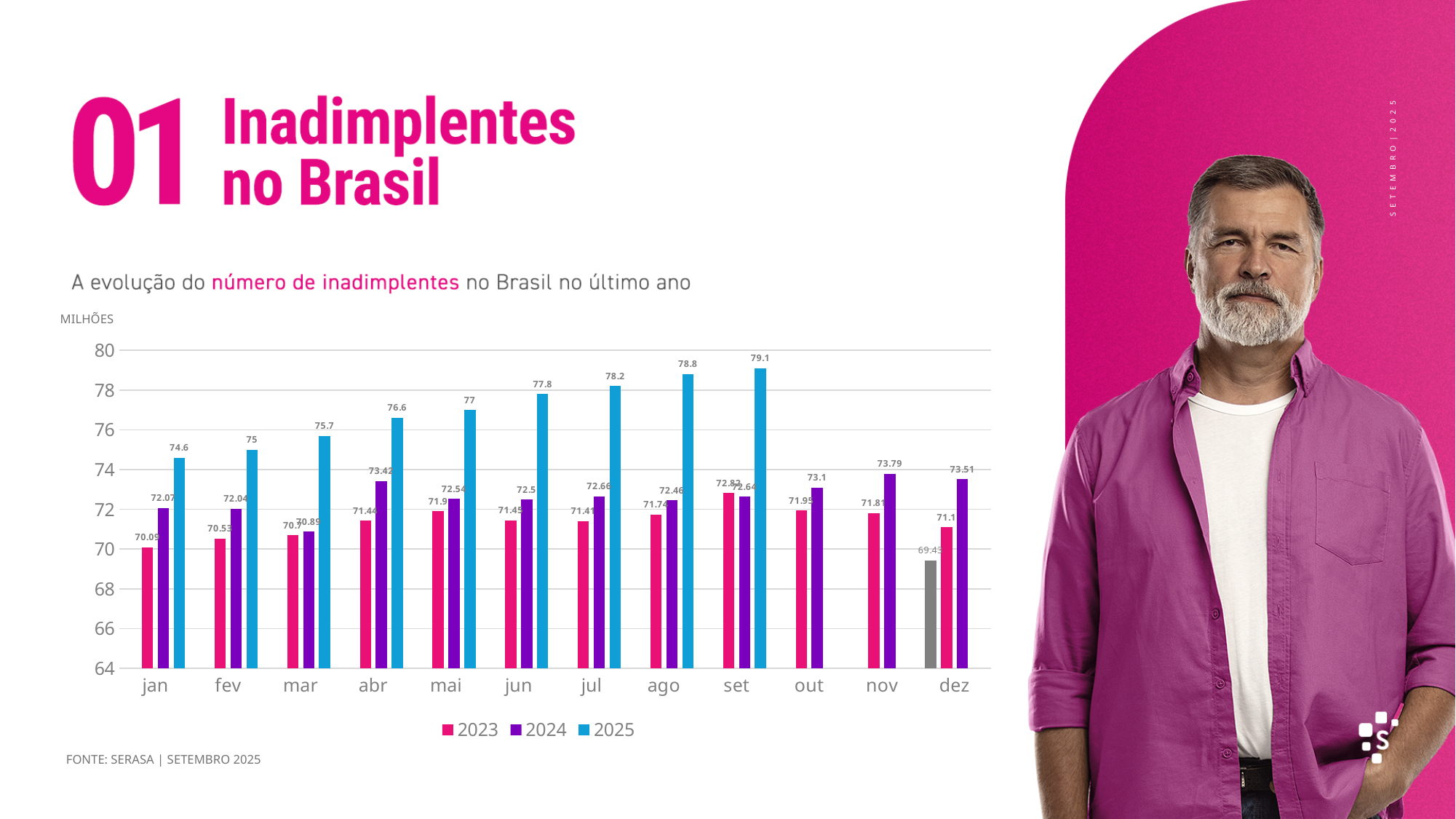
What is the value for 2024 in nov? 73.79 What kind of chart is shown on the slide? bar chart Do the 2025 values rise or fall from jan to set? rise Which month has the highest value for the 2025 series? set How many months are shown on the x axis? 12 What is the value for 2025 in set? 79.1 What is the difference between the 2025 values for set and jan? 4.5 What unit is indicated above the y axis? MILHÕES Which month has the lowest value for the 2023 series? jan How many series does the legend list? 3 Which is larger, the 2025 value for jul or the 2025 value for ago? ago What is the value for 2023 in jan? 70.09